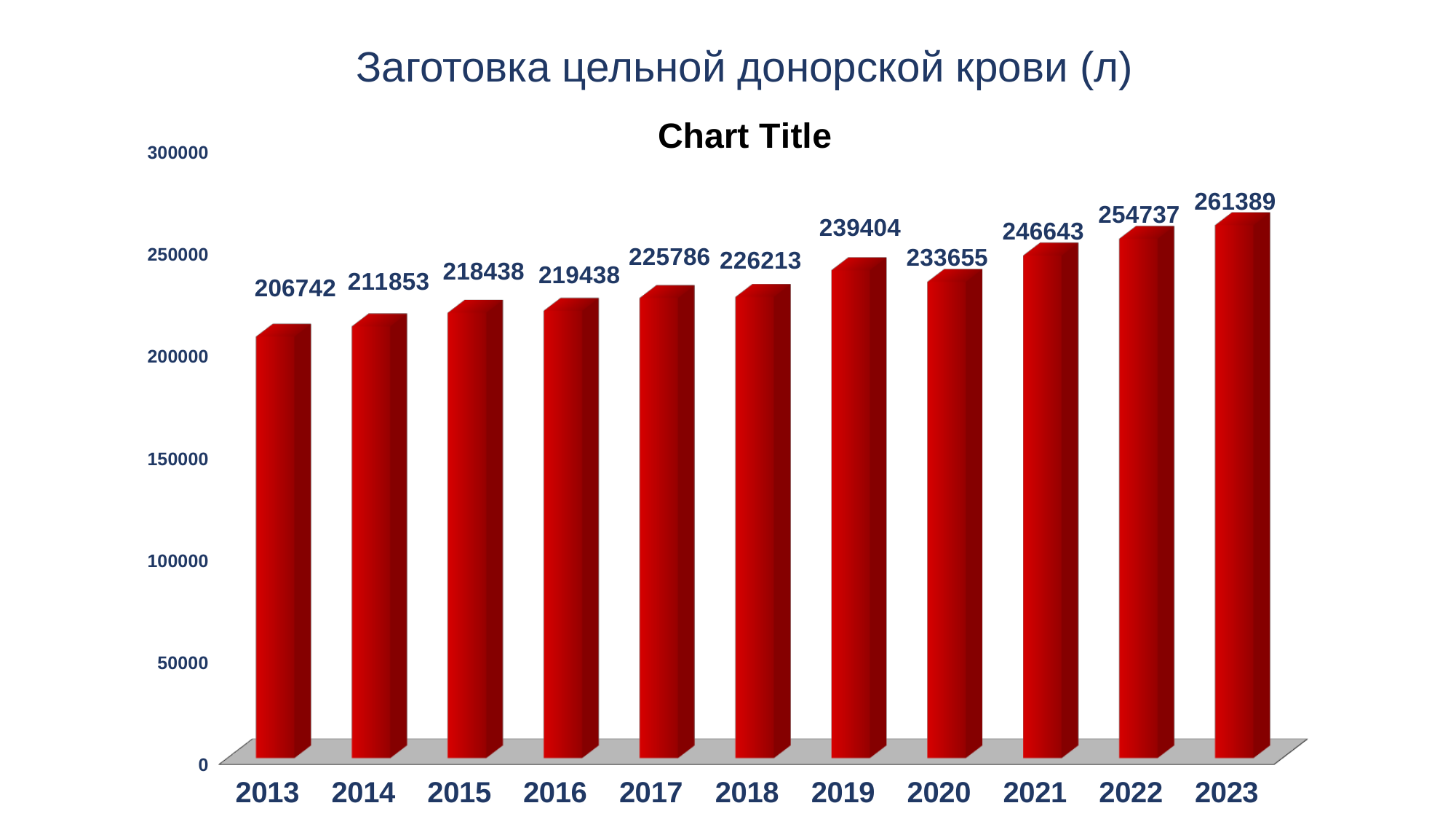
What is the difference between the values for 2020 and 2019? 5749 Which year has the lowest value? 2013 What is the value for 2013? 206742 Which is larger, the value for 2018 or the value for 2020? 2020 How many years are shown on the x axis? 11 Do the values generally rise or fall from 2013 to 2023? rise Is the value for 2021 greater or less than 200000? greater What is the difference between the values for 2023 and 2013? 54647 What is the value for 2019? 239404 What is the value for 2023? 261389 Which year has the highest value? 2023 What kind of chart is shown on the slide? bar chart